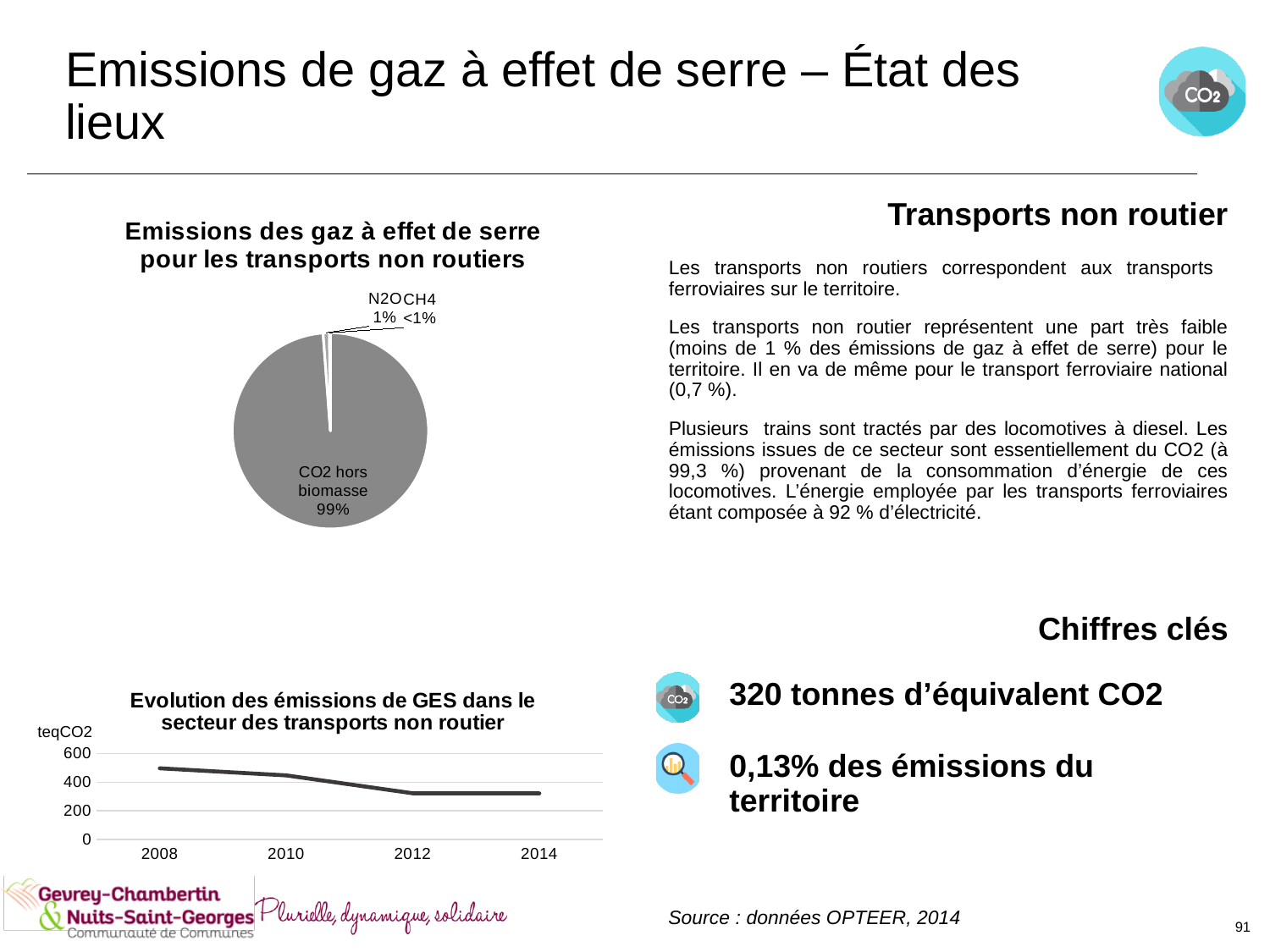
What unit is shown on the y axis of the chart 'Evolution des émissions de GES dans le secteur des transports non routier'? teqCO2 In the chart 'Evolution des émissions de GES dans le secteur des transports non routier', which year has the larger value, 2008 or 2014? 2008 How many slices does the pie chart 'Emissions des gaz à effet de serre pour les transports non routiers' have? 3 In the pie chart 'Emissions des gaz à effet de serre pour les transports non routiers', which slice is the largest? CO2 hors biomasse What kind of chart is the chart titled 'Emissions des gaz à effet de serre pour les transports non routiers'? pie chart In the pie chart 'Emissions des gaz à effet de serre pour les transports non routiers', what share does 'CO2 hors biomasse' have? 99% What kind of chart is the chart titled 'Evolution des émissions de GES dans le secteur des transports non routier'? line chart In the chart 'Evolution des émissions de GES dans le secteur des transports non routier', do the values rise or fall from 2008 to 2014? fall In the chart 'Evolution des émissions de GES dans le secteur des transports non routier', is the value for 2012 greater or less than 400? less In the pie chart 'Emissions des gaz à effet de serre pour les transports non routiers', what share does N2O have? 1% How many years are shown on the x axis of the chart 'Evolution des émissions de GES dans le secteur des transports non routier'? 4 In the chart 'Evolution des émissions de GES dans le secteur des transports non routier', is the value for 2008 greater or less than 400? greater